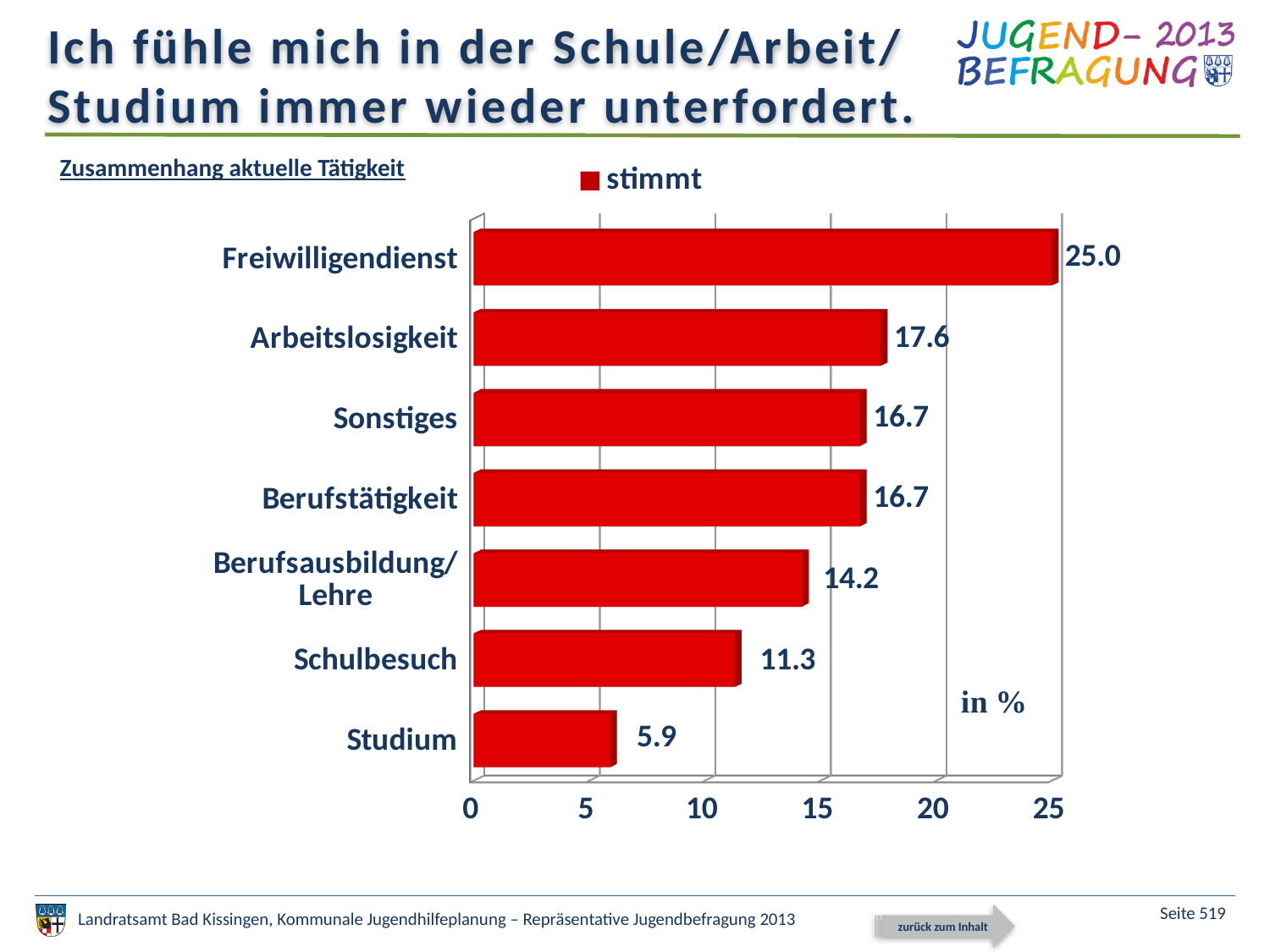
Which is larger, the value for Arbeitslosigkeit or the value for Berufsausbildung/Lehre? Arbeitslosigkeit How many categories are shown in the chart? 7 What kind of chart is shown on the slide? bar chart Is the value for Studium greater or less than 10? less What is the value for Freiwilligendienst? 25.0 What is the value for Berufsausbildung/Lehre? 14.2 What is the value for Schulbesuch? 11.3 What series name does the legend show? stimmt Which category has the highest value? Freiwilligendienst What is the difference between the values for Schulbesuch and Studium? 5.4 What is the difference between the values for Freiwilligendienst and Arbeitslosigkeit? 7.4 Which category has the lowest value? Studium